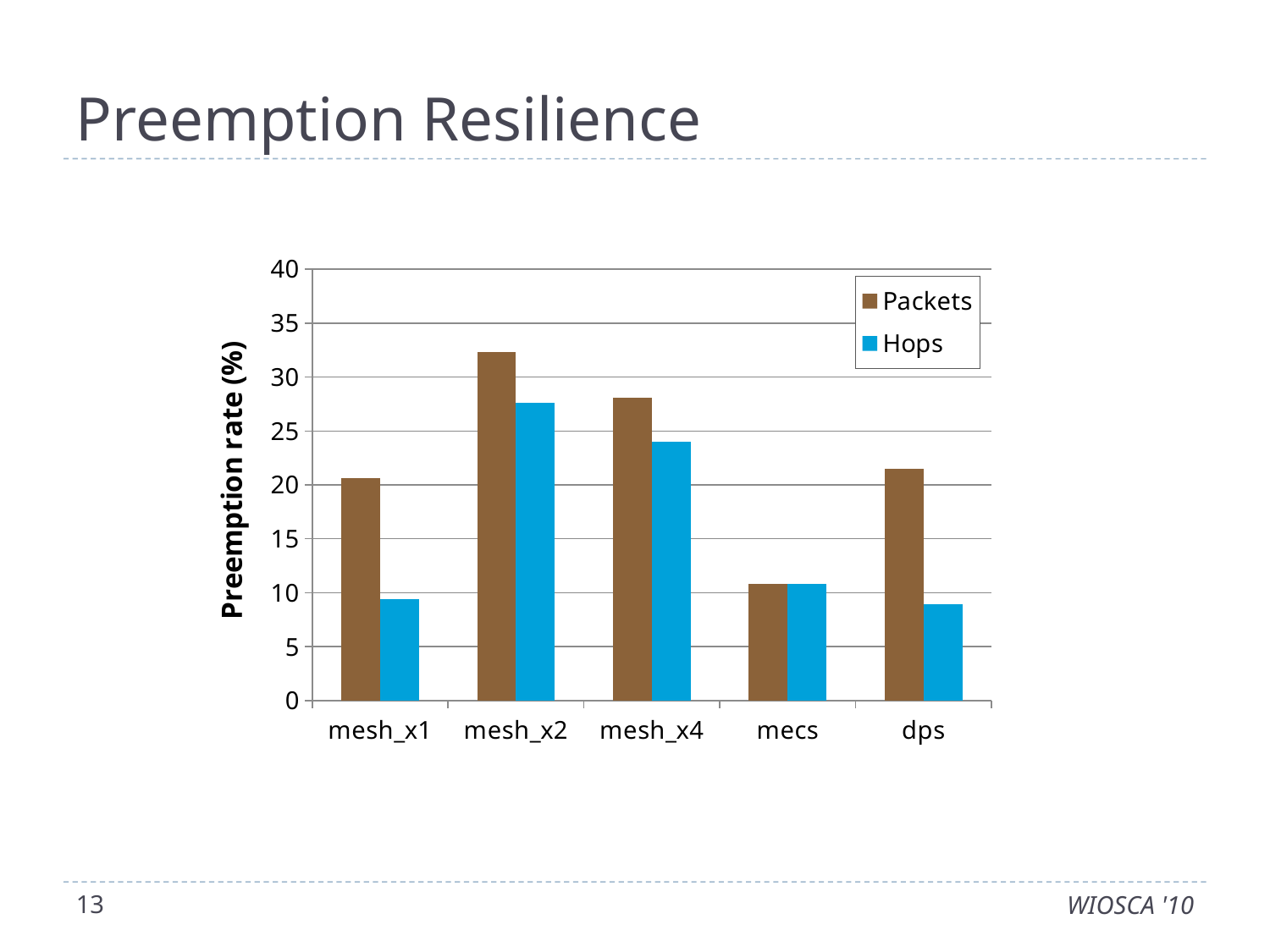
What kind of chart is shown on the slide? bar chart How many series does the legend list? 2 Is the Packets value for mesh_x2 greater or less than 30? greater Which category has the highest Packets value? mesh_x2 Is the Packets value for mesh_x1 greater or less than 20? greater How many categories are shown on the x axis? 5 Is the Hops value for dps greater or less than 10? less Which is larger for mesh_x4, the Packets value or the Hops value? Packets Which category has the highest Hops value? mesh_x2 Which is larger, the Hops value for mesh_x2 or the Hops value for mesh_x4? mesh_x2 What is the label of the y axis? Preemption rate (%) Which category has the lowest Packets value? mecs